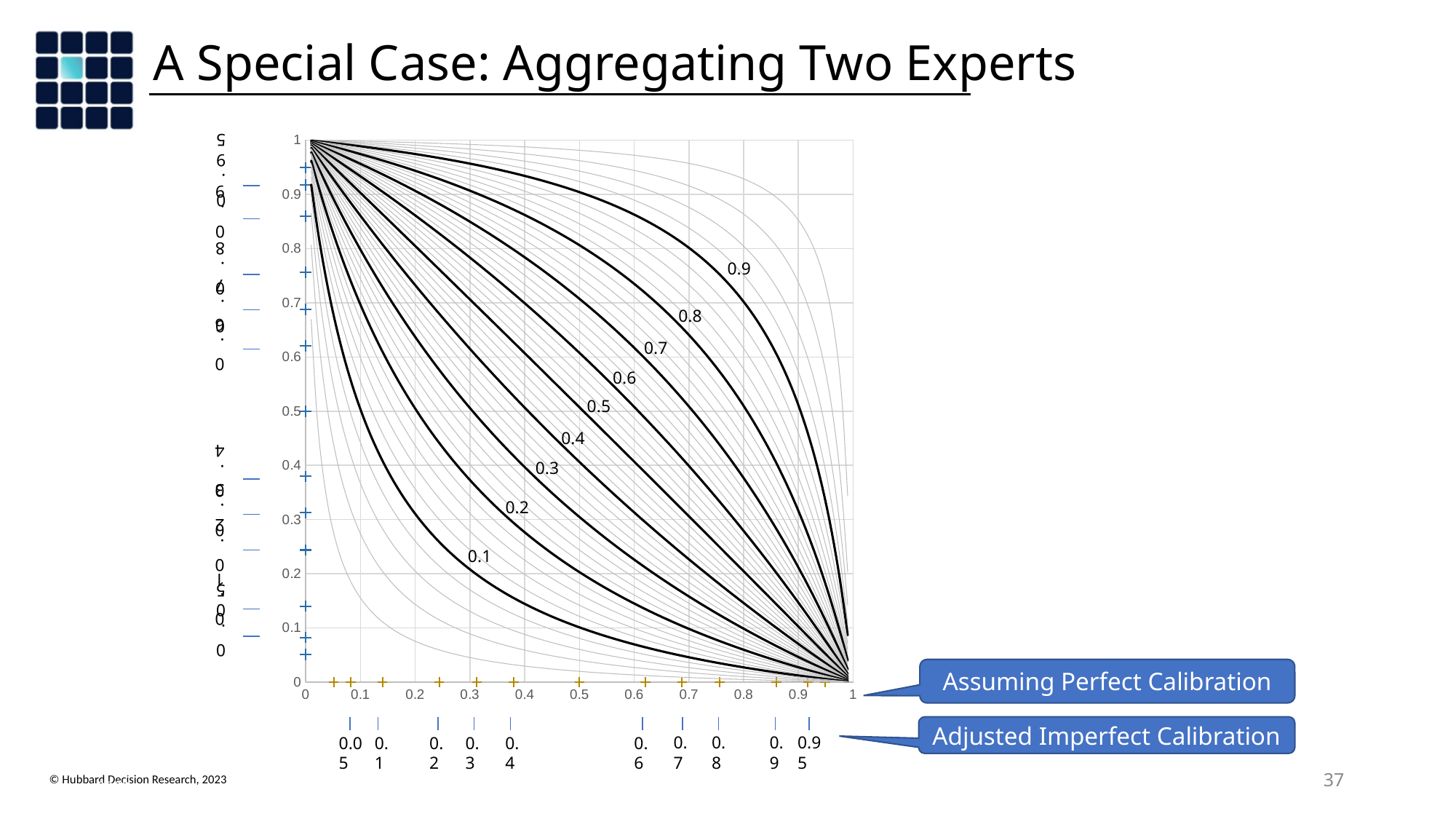
What does the callout pointing to the lower row of tick marks beneath the chart say? Adjusted Imperfect Calibration What is the label on the lowest bold curve in the chart? 0.1 Is the value of the curve labeled 0.9 at x = 0.5 greater or less than 0.8? greater Which curve is higher on the chart, the one labeled 0.7 or the one labeled 0.3? 0.7 Do the bold curves rise or fall as the x value increases from 0 to 1? fall Is the value of the curve labeled 0.1 at x = 0.5 greater or less than 0.2? less What kind of chart is shown on the slide? line chart What is the maximum value shown on the chart's x axis? 1 What is the maximum value shown on the chart's y axis? 1 How many bold labeled curves are drawn on the chart? 9 What is the label on the highest bold curve in the chart? 0.9 Which curve is lower on the chart, the one labeled 0.2 or the one labeled 0.6? 0.2